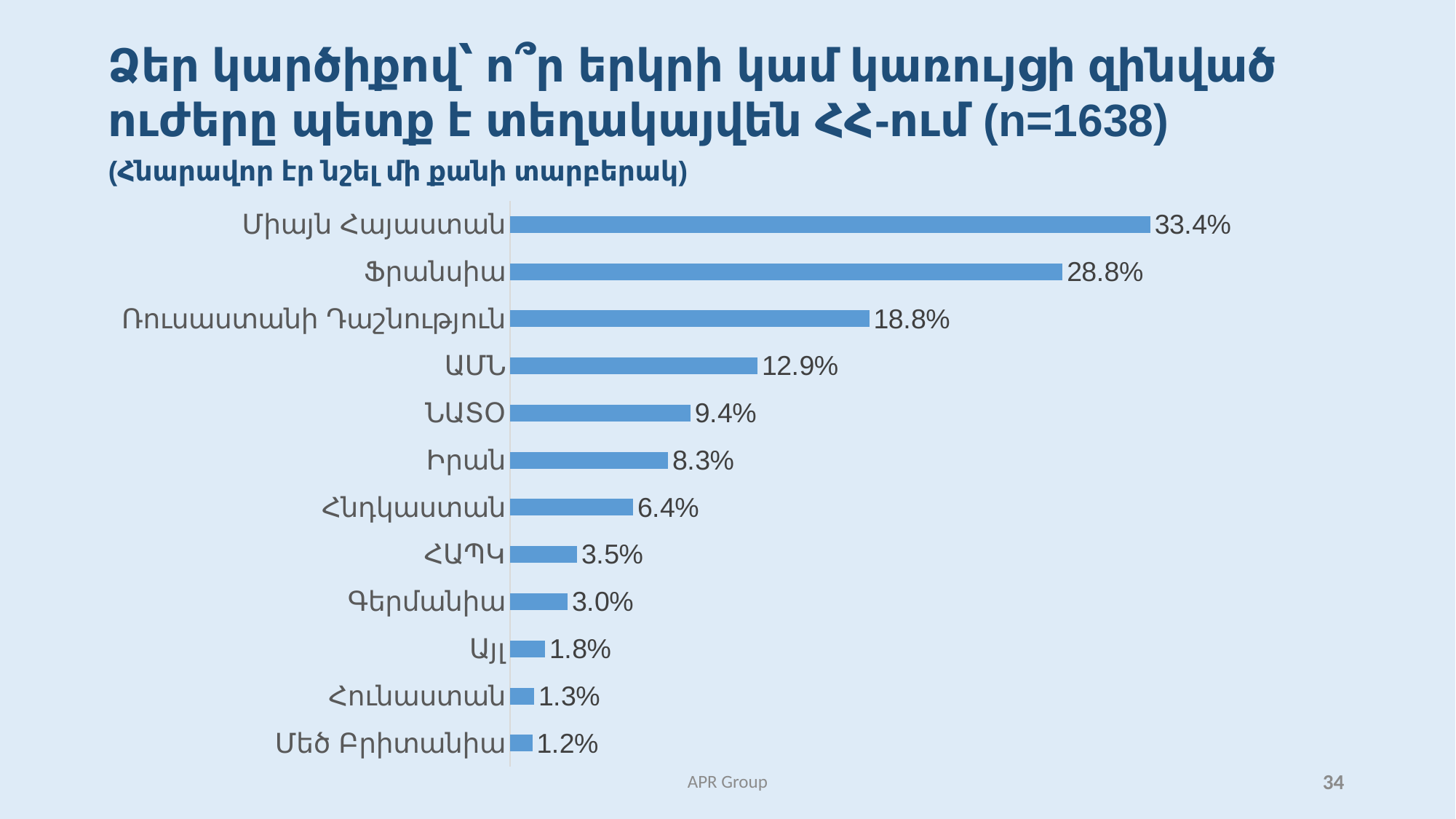
Which category has the lowest value? Մեծ Բրիտանիա What is the difference between the values for Ռուսաստանի Դաշնություն and ԱՄՆ? 5.9% What is the value for Իրան? 8.3% What is the value for Գերմանիա? 3.0% What is the value for ԱՄՆ? 12.9% What is the sample size (n) stated in the chart title? 1638 Which is larger, the value for ՆԱՏՕ or the value for Հնդկաստան? ՆԱՏՕ What is the value for Ֆրանսիա? 28.8% Which category has the highest value? Միայն Հայաստան What kind of chart is shown on the slide? bar chart What is the difference between the values for Միայն Հայաստան and Ֆրանսիա? 4.6% How many categories are plotted in the chart? 12